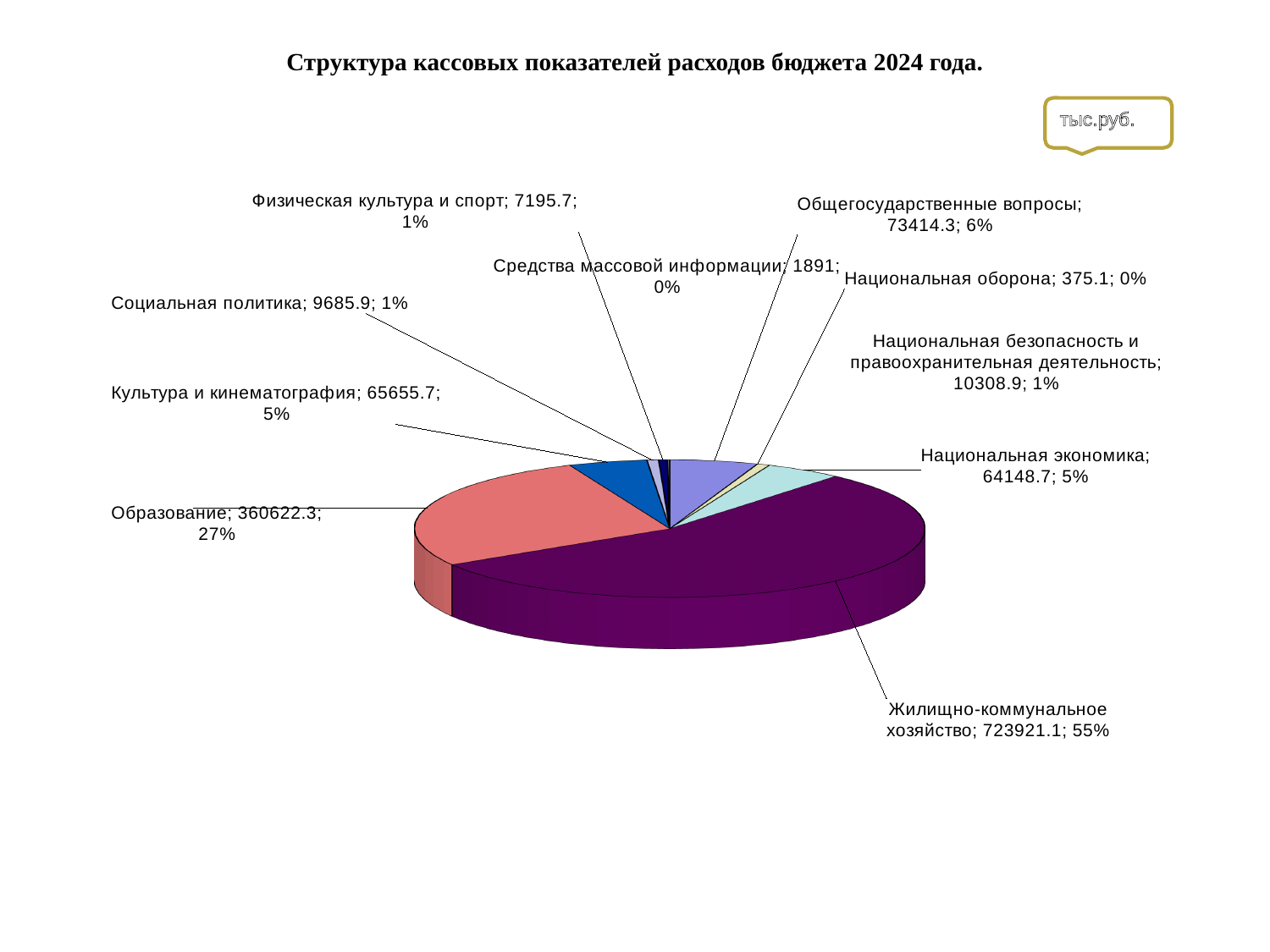
What share of the pie does Образование represent? 27% What share of the pie does Общегосударственные вопросы represent? 6% What is the value for Образование? 360622.3 How many categories are shown in the pie chart? 10 What is the value for Жилищно-коммунальное хозяйство? 723921.1 Which category has the largest slice of the pie? Жилищно-коммунальное хозяйство Which is larger, the value for Общегосударственные вопросы or the value for Национальная экономика? Общегосударственные вопросы What is the difference between the values for Образование and Культура и кинематография? 294966.6 Which category has the smallest value? Национальная оборона What is the value for Культура и кинематография? 65655.7 What type of chart is shown on the slide? Pie chart What is the value for Национальная оборона? 375.1